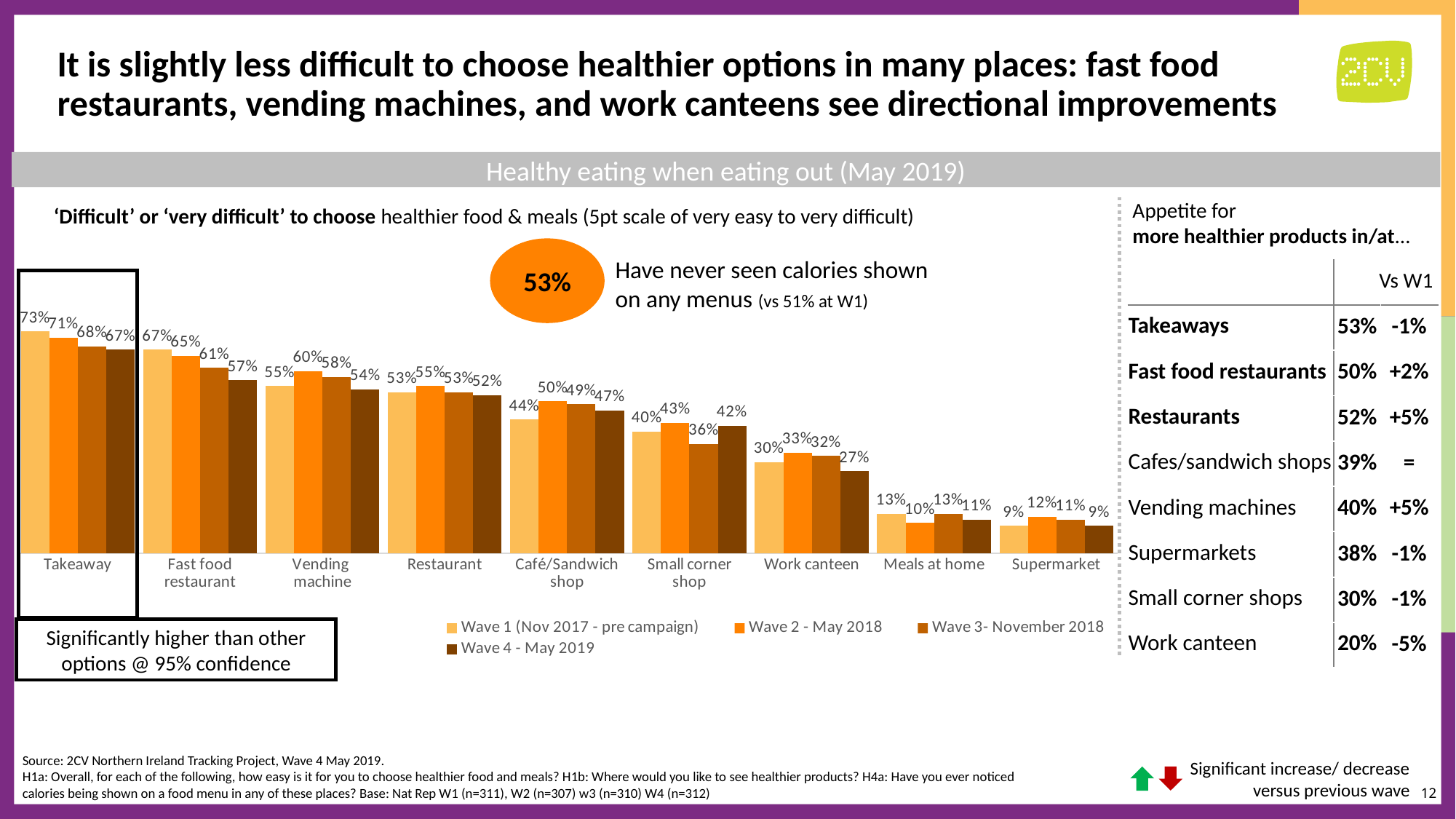
How many series does the chart legend list? 4 How many categories are shown on the x axis of the chart? 9 Which category has the lowest Wave 1 (Nov 2017 - pre campaign) value? Supermarket What is the Wave 1 (Nov 2017 - pre campaign) value for Fast food restaurant? 67% What is the Wave 4 - May 2019 value for Takeaway? 67% What is the Wave 3- November 2018 value for Small corner shop? 36% Do the Wave 4 - May 2019 values for Takeaway, Fast food restaurant, Vending machine and Restaurant rise or fall from left to right? Fall Which is larger for Work canteen: the Wave 2 - May 2018 value or the Wave 4 - May 2019 value? Wave 2 - May 2018 Which category has the highest Wave 4 - May 2019 value? Takeaway What is the Wave 2 - May 2018 value for Vending machine? 60% What kind of chart is shown on the slide? Bar chart What is the difference between the Wave 1 and Wave 4 values for Fast food restaurant? 10%